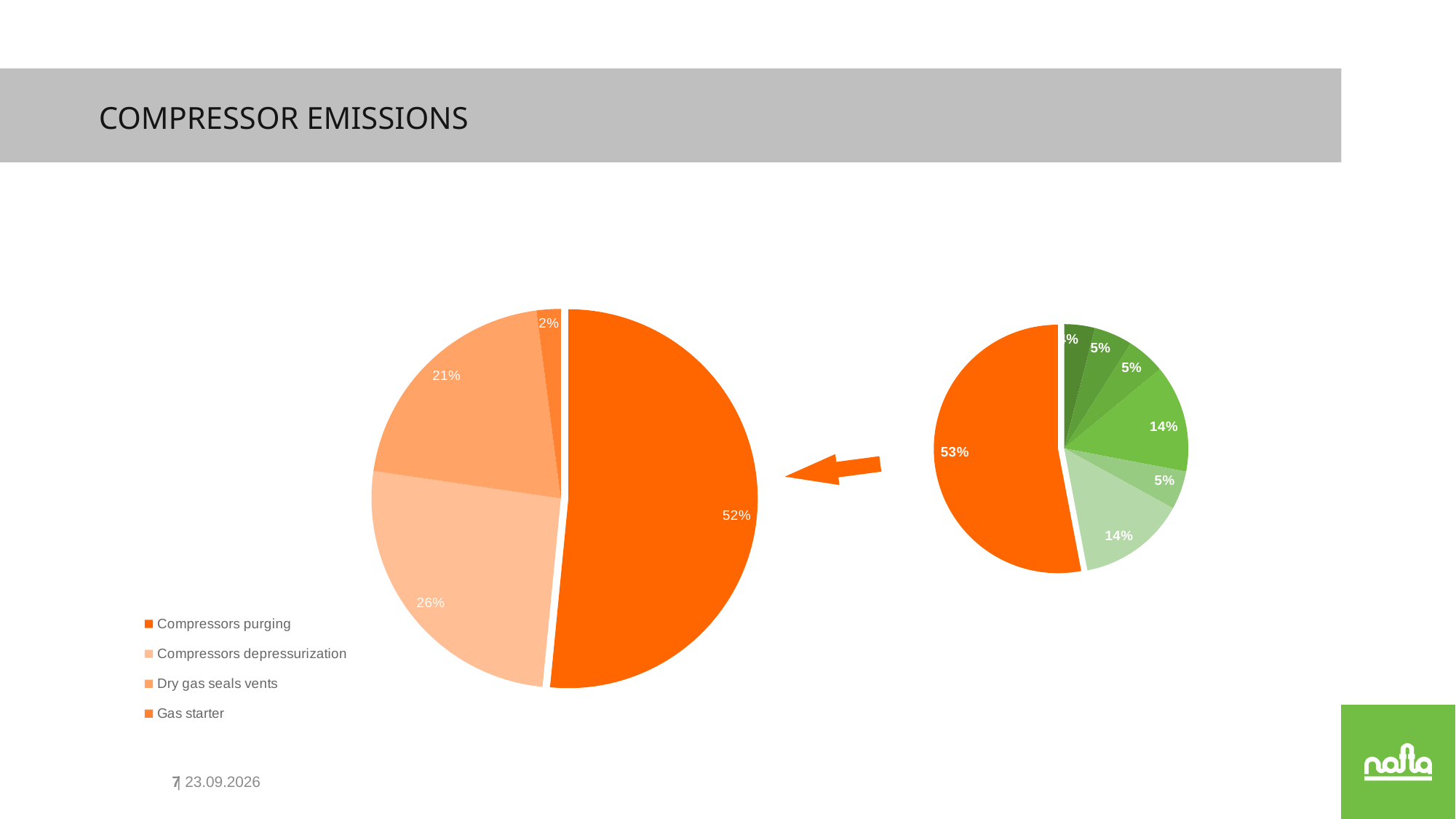
In the left pie chart, what share of compressor emissions comes from Compressors purging? 52% What type of chart is used on this slide to show compressor emissions? Pie chart In the left pie chart, what share does Gas starter account for? 2% In the small pie chart on the right, what is the value of the largest (orange) slice? 53% In the left pie chart, which category has the largest slice? Compressors purging In the left pie chart, what percentage is shown for Dry gas seals vents? 21% In the left pie chart, what percentage is shown for Compressors depressurization? 26% In the left pie chart, how many percentage points larger is Compressors purging than Compressors depressurization? 26 percentage points In the left pie chart, which is larger: Dry gas seals vents or Compressors depressurization? Compressors depressurization In the left pie chart, which category has the smallest slice? Gas starter How many pie charts are shown on the slide? 2 How many categories does the legend of the left pie chart list? 4